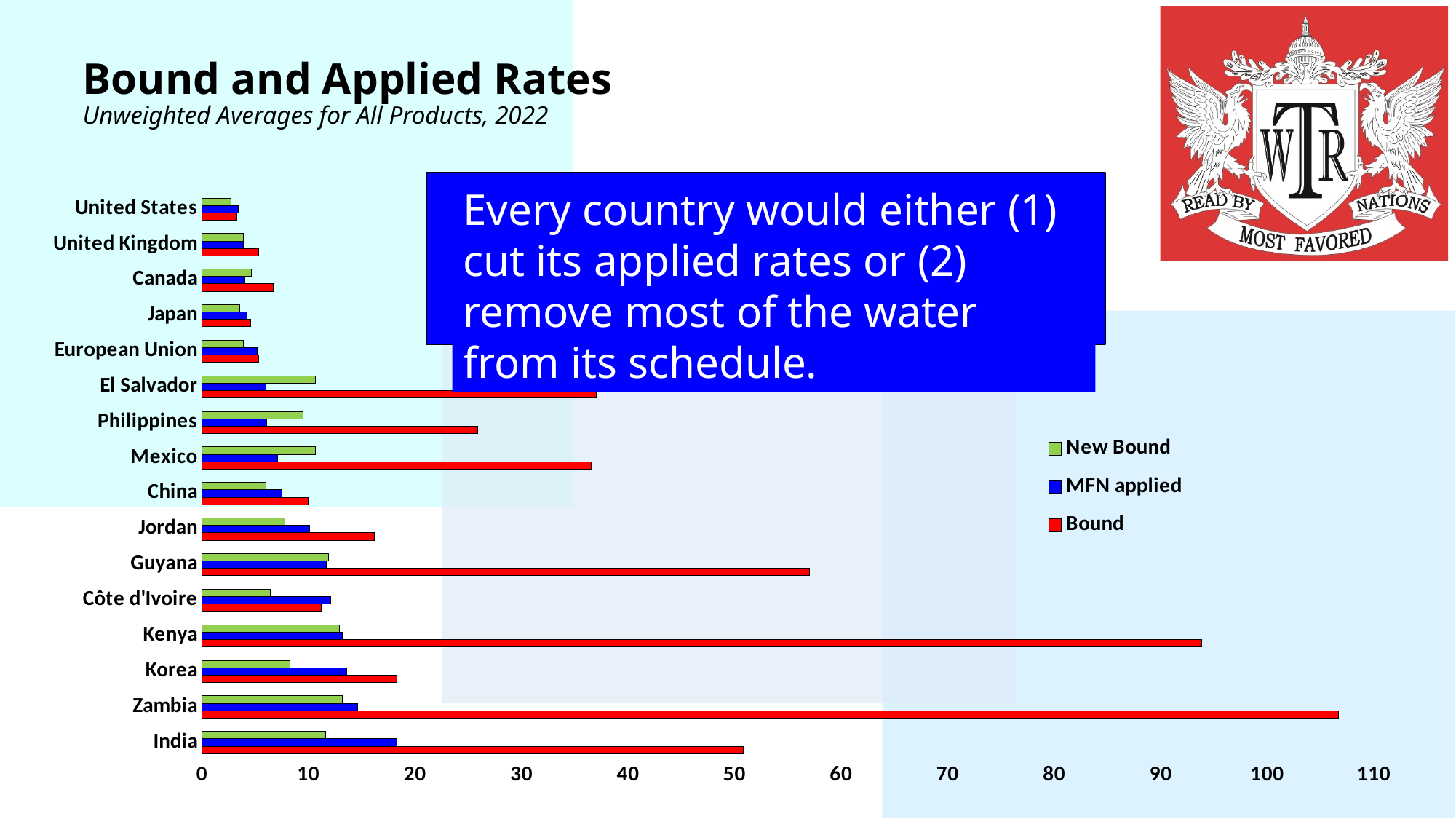
Is the Bound value for Zambia greater or less than 100? greater How many countries or regions are plotted on the chart? 16 Is the Bound value for Guyana greater or less than 50? greater Is the Bound value for India greater or less than 60? less What colour represents the Bound series in the legend? Red What kind of chart is shown on the slide? Bar chart Which is larger, the Bound value for Guyana or the Bound value for India? Guyana What is the title of the chart on the slide? Bound and Applied Rates How many series does the chart's legend list? 3 Which country has the highest Bound rate? Zambia